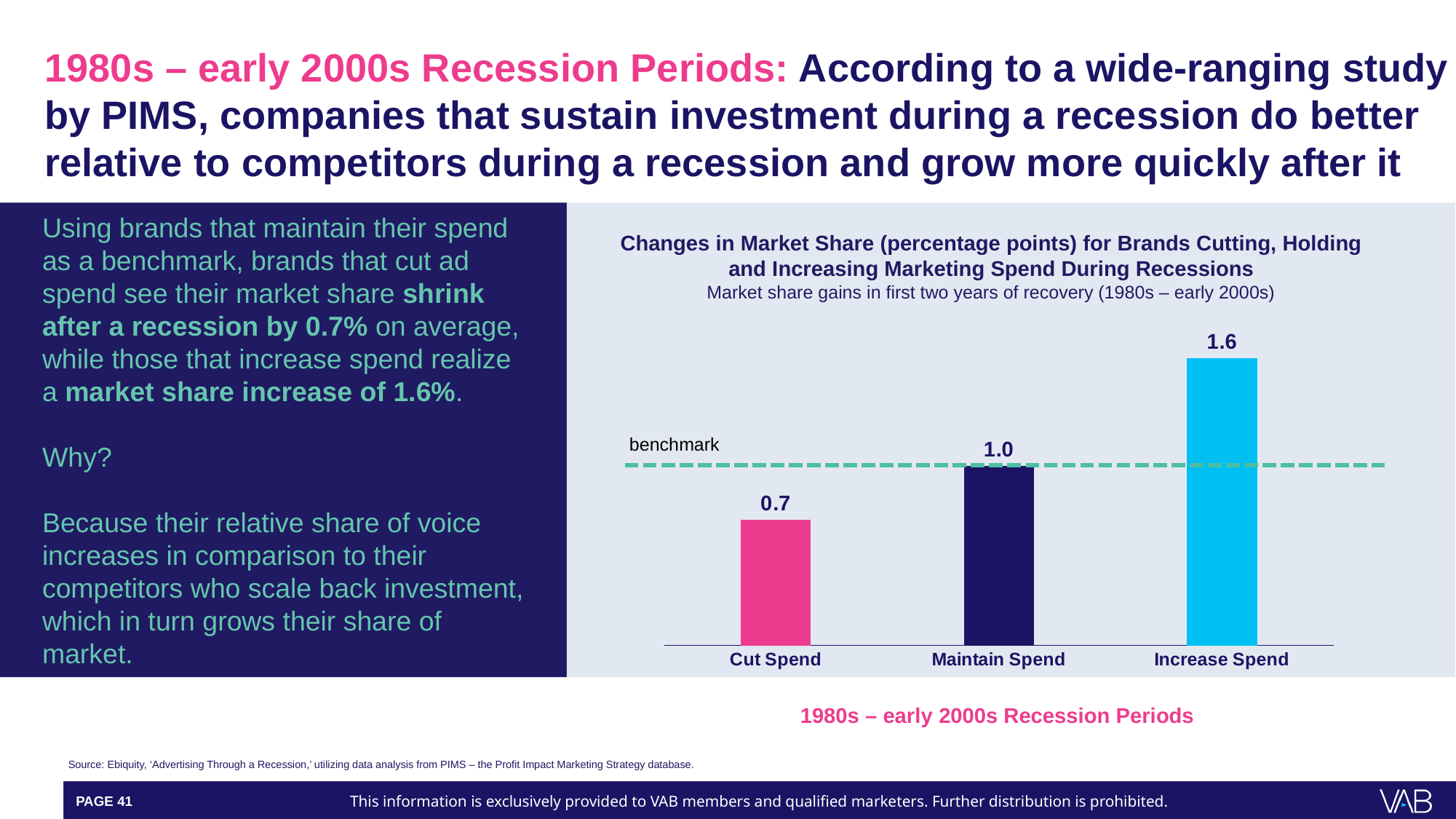
Do the values rise or fall from Cut Spend to Increase Spend? Rise How many categories are shown in the chart? 3 Which is larger, the value for Cut Spend or the value for Maintain Spend? Maintain Spend Which category has the lowest value? Cut Spend What kind of chart is shown on the slide? Bar chart What is the value for Cut Spend? 0.7 What is the difference between the values for Increase Spend and Cut Spend? 0.9 What is the value for Maintain Spend? 1.0 What does the dashed horizontal line in the chart represent? benchmark What is the value for Increase Spend? 1.6 What is the difference between the values for Increase Spend and Maintain Spend? 0.6 Which category has the highest value? Increase Spend